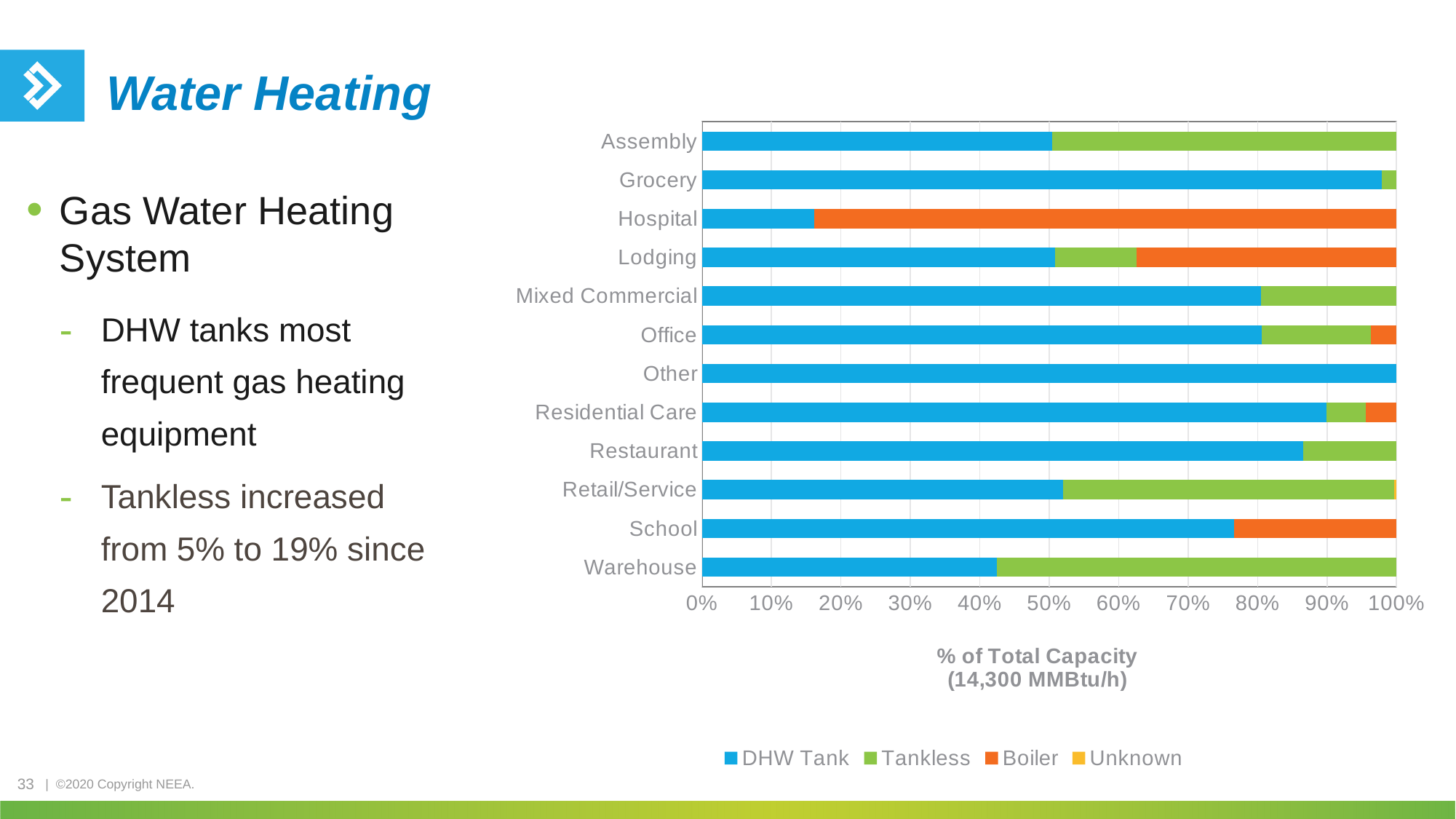
Is the DHW Tank share for Hospital greater or less than 20%? less How many series does the chart legend list? 4 What is the title of the chart's horizontal axis? % of Total Capacity (14,300 MMBtu/h) Which category has the largest DHW Tank share? Other How many building categories are listed on the chart's vertical axis? 12 Which category has the smallest DHW Tank share? Hospital What kind of chart is shown on the slide? Stacked bar chart Is the DHW Tank share for Mixed Commercial greater or less than 70%? greater Is the DHW Tank share for Warehouse greater or less than 50%? less Which category has the largest Boiler share? Hospital Which has the larger DHW Tank share, Grocery or Hospital? Grocery Which category has the largest Tankless share? Warehouse